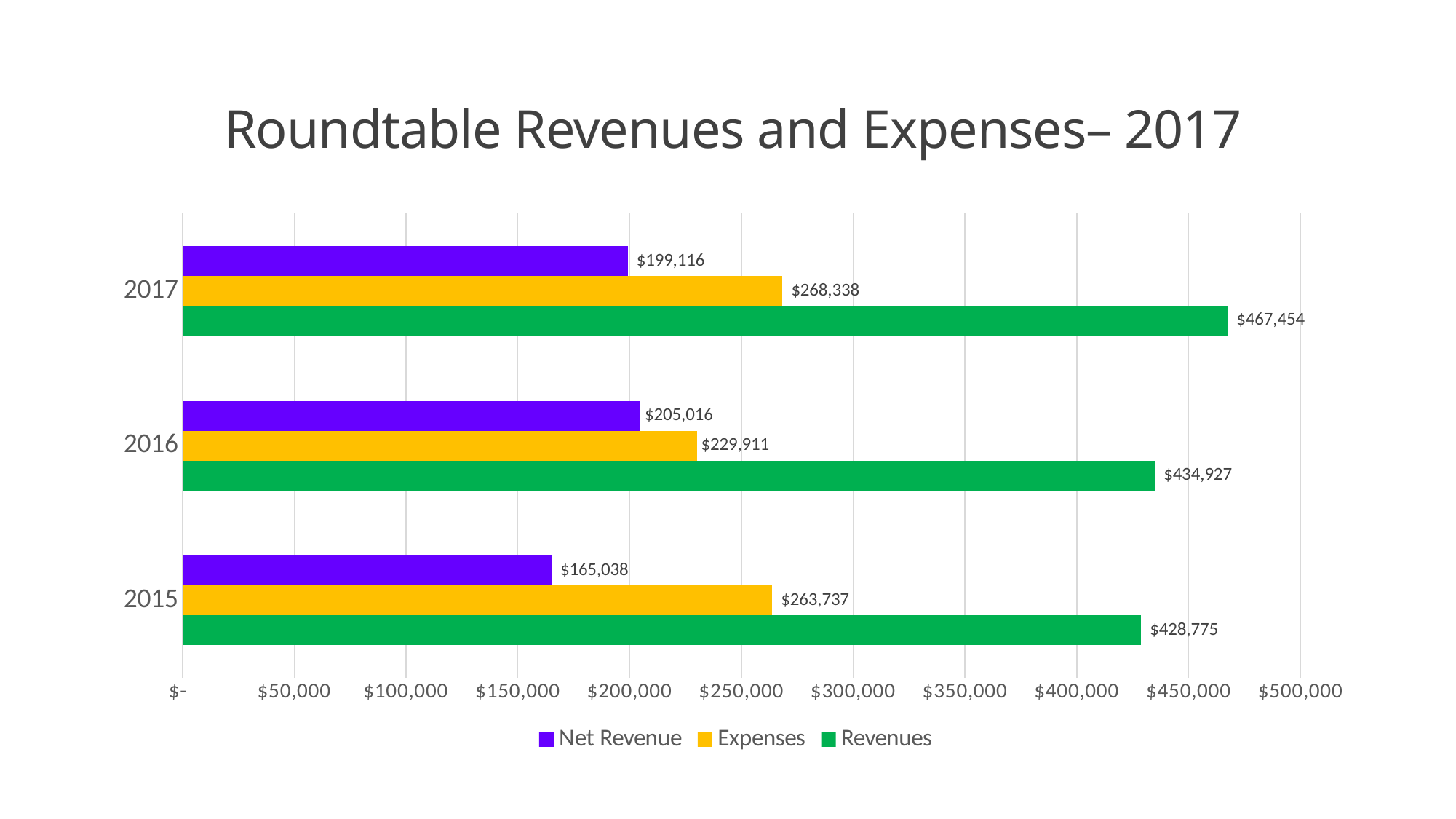
What colour are the Expenses bars? yellow How many series does the legend list? 3 Which year has the lowest Net Revenue? 2015 Is the Net Revenue for 2016 greater or less than $200,000? greater What kind of chart is shown on the slide? bar chart What is the Net Revenue value for 2015? $165,038 Which is larger, Expenses in 2015 or Expenses in 2016? Expenses in 2015 What is the Revenues value for 2017? $467,454 How many years are shown on the chart? 3 Which year has the highest Revenues? 2017 What is the Expenses value for 2016? $229,911 What is the difference between Revenues and Expenses in 2017? $199,116